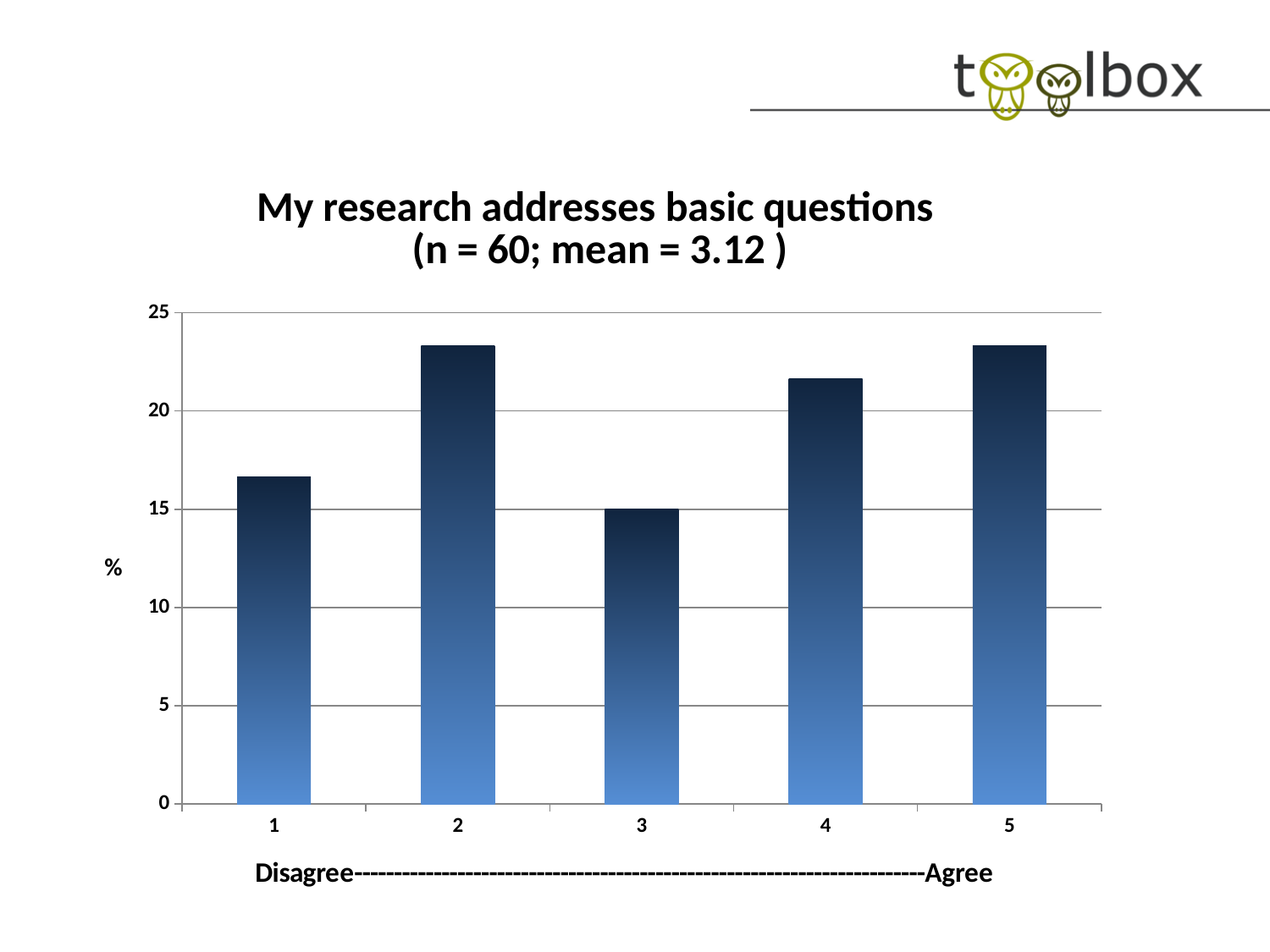
What label is shown on the y axis? % How many categories are plotted on the x axis? 5 Which category has the lowest value? 3 Is the value for category 2 greater or less than 20? greater What is the value for category 3? 15 What kind of chart is shown on the slide? bar chart Is the value for category 1 greater or less than 20? less Is the value for category 4 greater or less than 20? greater Which is larger, the value for category 4 or the value for category 1? 4 What is the title of the chart? My research addresses basic questions (n = 60; mean = 3.12 ) Which is larger, the value for category 2 or the value for category 3? 2